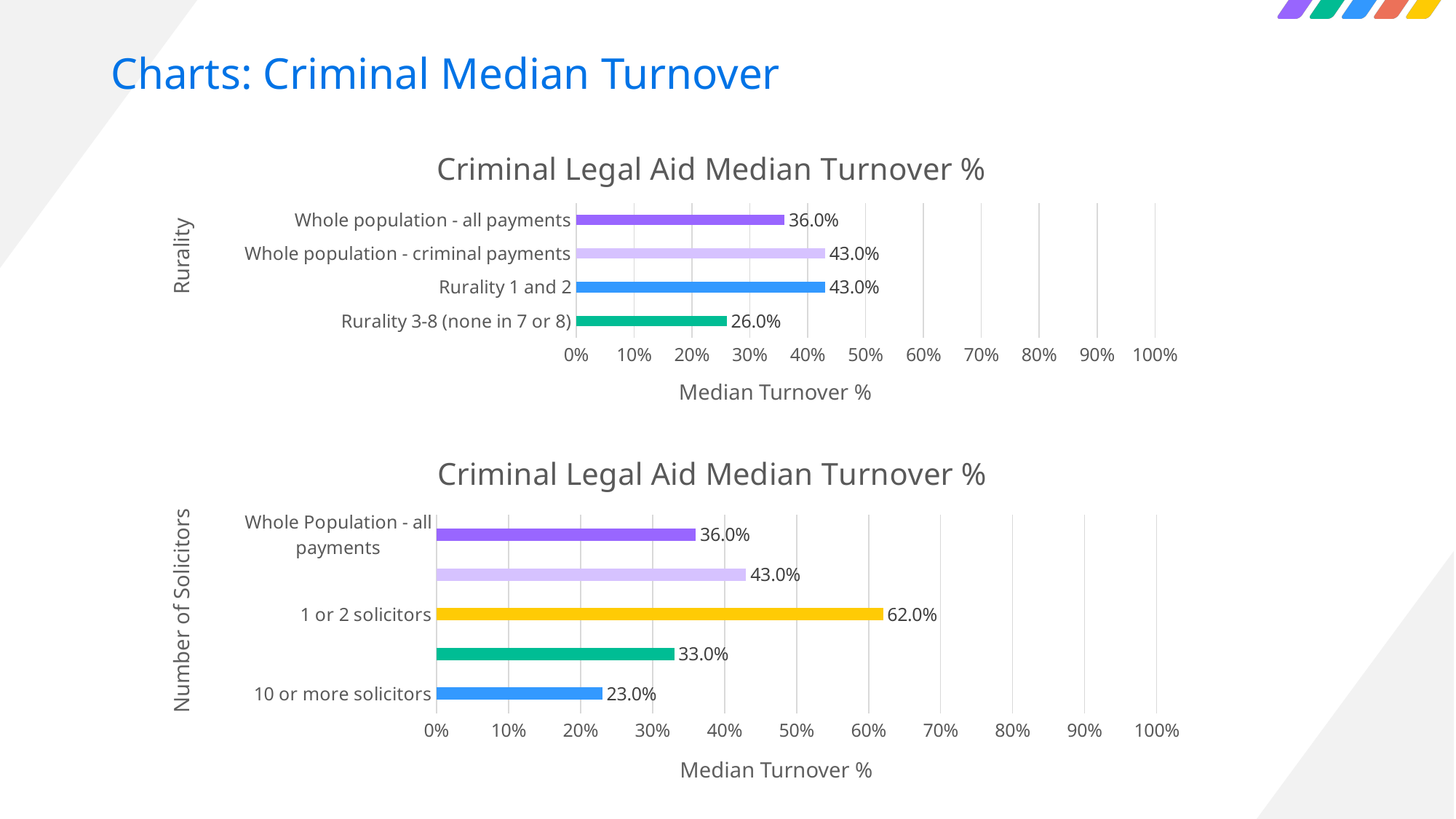
In the top chart, what is the median turnover % for Rurality 1 and 2? 43.0% In the bottom chart, which category has the highest median turnover %? 1 or 2 solicitors In the top chart, how many categories are plotted? 4 In the top chart, what is the median turnover % for Rurality 3-8 (none in 7 or 8)? 26.0% In the top chart, which category has the lowest median turnover %? Rurality 3-8 (none in 7 or 8) In the bottom chart, what is the difference between the values for 1 or 2 solicitors and 10 or more solicitors? 39.0% In the bottom chart, which is larger: the value for 1 or 2 solicitors or the value for Whole Population - all payments? 1 or 2 solicitors In the bottom chart, what is the median turnover % for 1 or 2 solicitors? 62.0% In the bottom chart, what is the median turnover % for 10 or more solicitors? 23.0% In the top chart, what is the difference between the values for Whole population - criminal payments and Whole population - all payments? 7.0% What type of chart is the top chart? Bar chart In the bottom chart, how many bars are plotted? 5